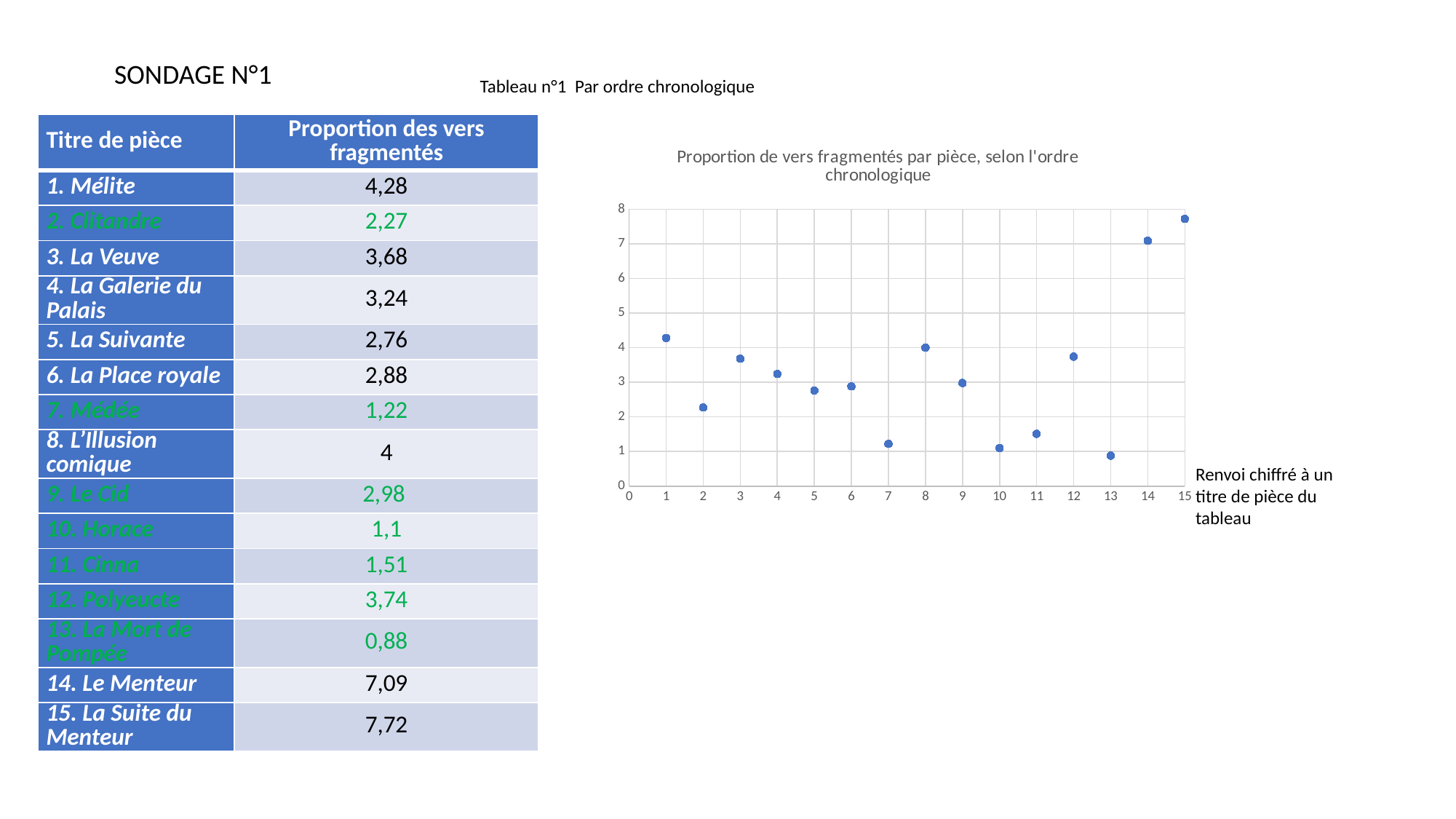
Which is larger, the value plotted at x = 14 or at x = 15? x = 15 Is the value plotted at x = 15 greater or less than 7? greater Which x-axis position (play number) has the highest value in the chart? 15 According to the table, what is the proportion of fragmented verses for play 15, La Suite du Menteur (the point at x = 15)? 7,72 What is the title of the chart? Proportion de vers fragmentés par pièce, selon l'ordre chronologique How many data points are plotted in the chart? 15 What kind of chart is shown on the slide? scatter chart Which is larger, the value plotted at x = 2 or at x = 7? x = 2 Which x-axis position (play number) has the lowest value in the chart? 13 Using the values in the table, what is the difference between the value at x = 15 (La Suite du Menteur) and the value at x = 1 (Mélite)? 3,44 Is the value plotted at x = 12 greater or less than 4? less Is the value plotted at x = 7 greater or less than 2? less